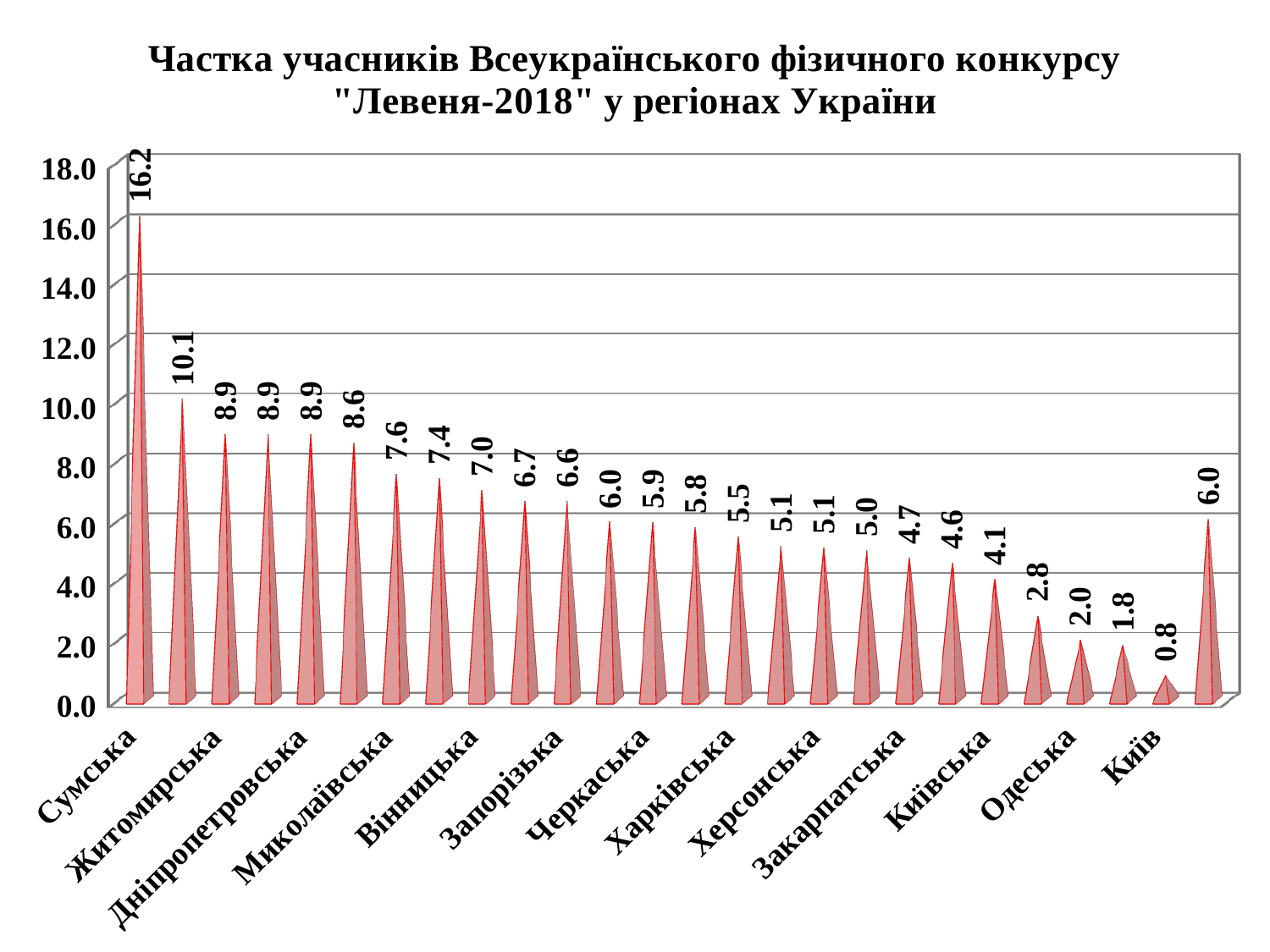
What is the value for Сумська? 16.2 Do the values generally rise or fall from left to right across the first 25 bars? fall Which region has the highest value? Сумська How many bars are plotted on the chart? 26 What is the difference between the highest value (16.2) and the lowest value (0.8)? 15.4 Which is larger, the value for Сумська or the value for Житомирська? Сумська What is the title of the chart? Частка учасників Всеукраїнського фізичного конкурсу "Левеня-2018" у регіонах України What is the value for Київ? 0.8 Is the value for Сумська greater or less than 14.0? greater What is the highest value shown on the chart? 16.2 What kind of chart is shown on the slide? bar chart What is the lowest value shown on the chart? 0.8